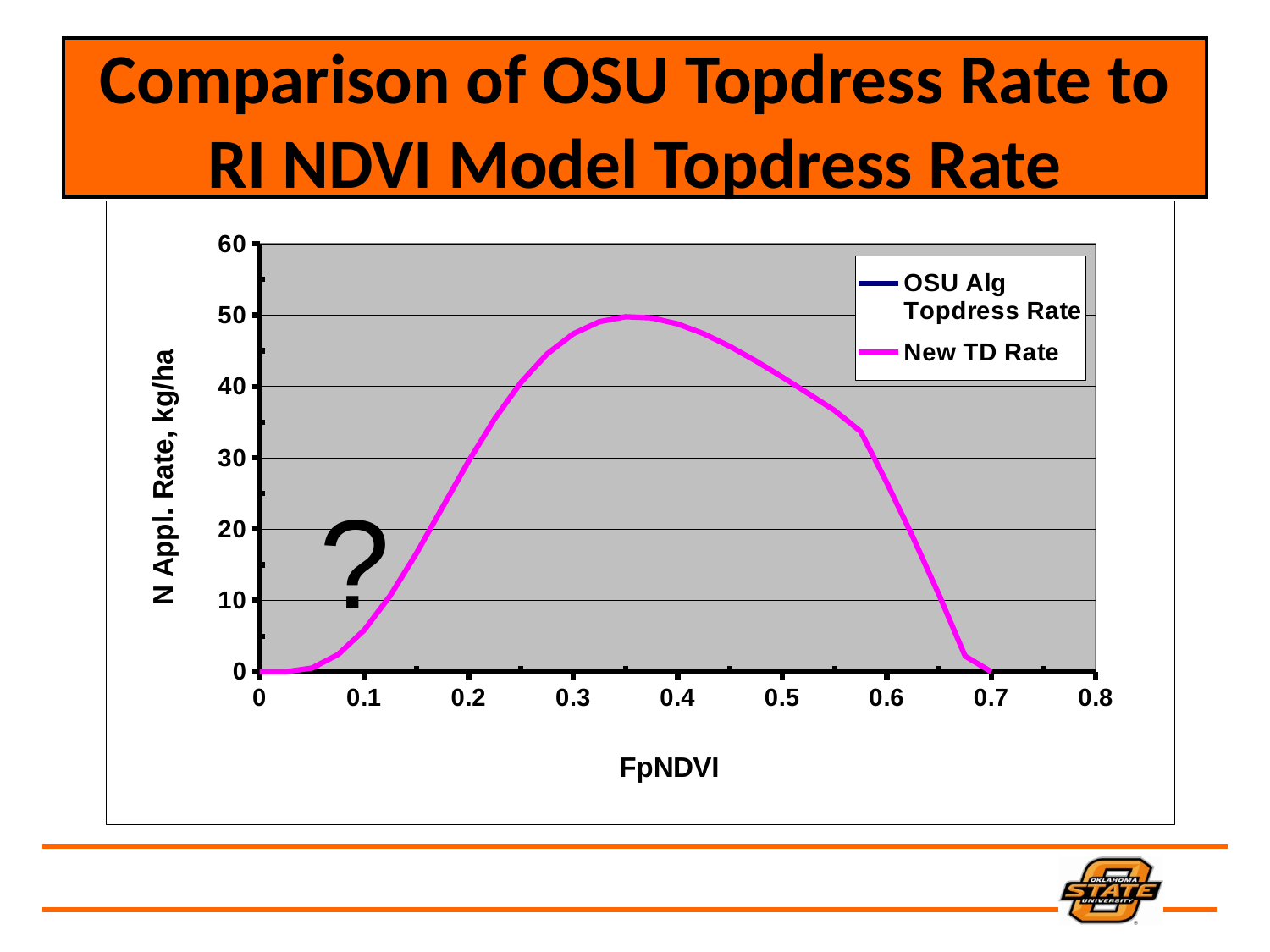
Does the New TD Rate line rise or fall as FpNDVI increases from 0.1 to 0.3? rise Is the New TD Rate value at FpNDVI 0.3 greater or less than 40? greater Is the New TD Rate value at FpNDVI 0.4 greater or less than 40? greater What is the title of the y axis? N Appl. Rate, kg/ha Which is larger, the New TD Rate value at FpNDVI 0.4 or at FpNDVI 0.6? FpNDVI 0.4 Is the New TD Rate value at FpNDVI 0.1 greater or less than 10? less Does the New TD Rate line rise or fall as FpNDVI increases from 0.4 to 0.7? fall What colour is the New TD Rate line? magenta How many series does the legend list? 2 What kind of chart is shown on the slide? line chart